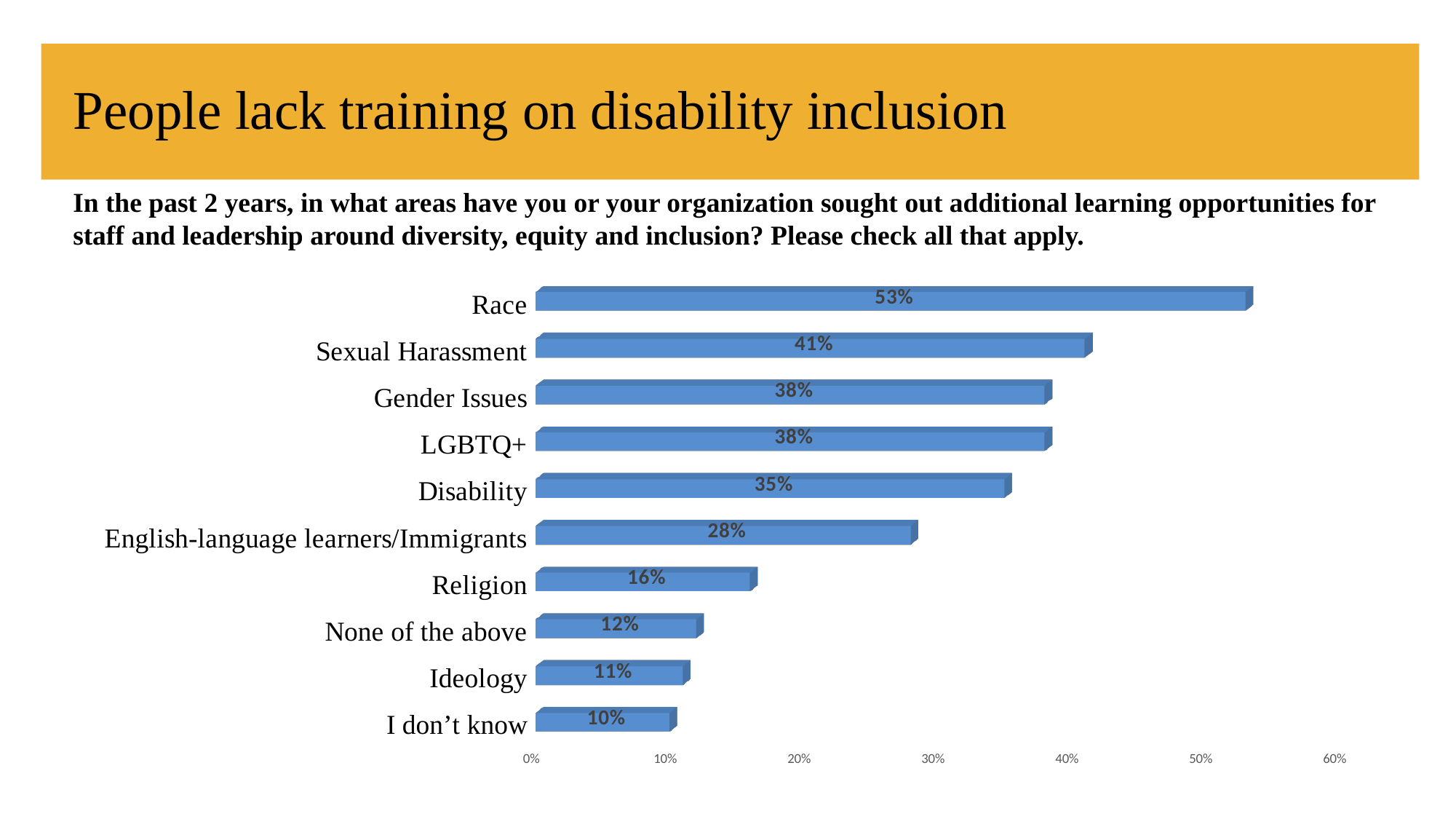
Which category has the lowest value? I don't know What percentage is shown for Race? 53% What kind of chart is shown on the slide? bar chart How many categories are shown in the chart? 10 Which category has the highest value? Race What is the title of the slide? People lack training on disability inclusion What percentage is shown for English-language learners/Immigrants? 28% Is the value for Religion greater or less than 20%? less What percentage is shown for Disability? 35% Which is larger, the value for Sexual Harassment or the value for Disability? Sexual Harassment What is the difference between the values for Race and Sexual Harassment? 12% What is the difference between the values for Disability and Religion? 19%